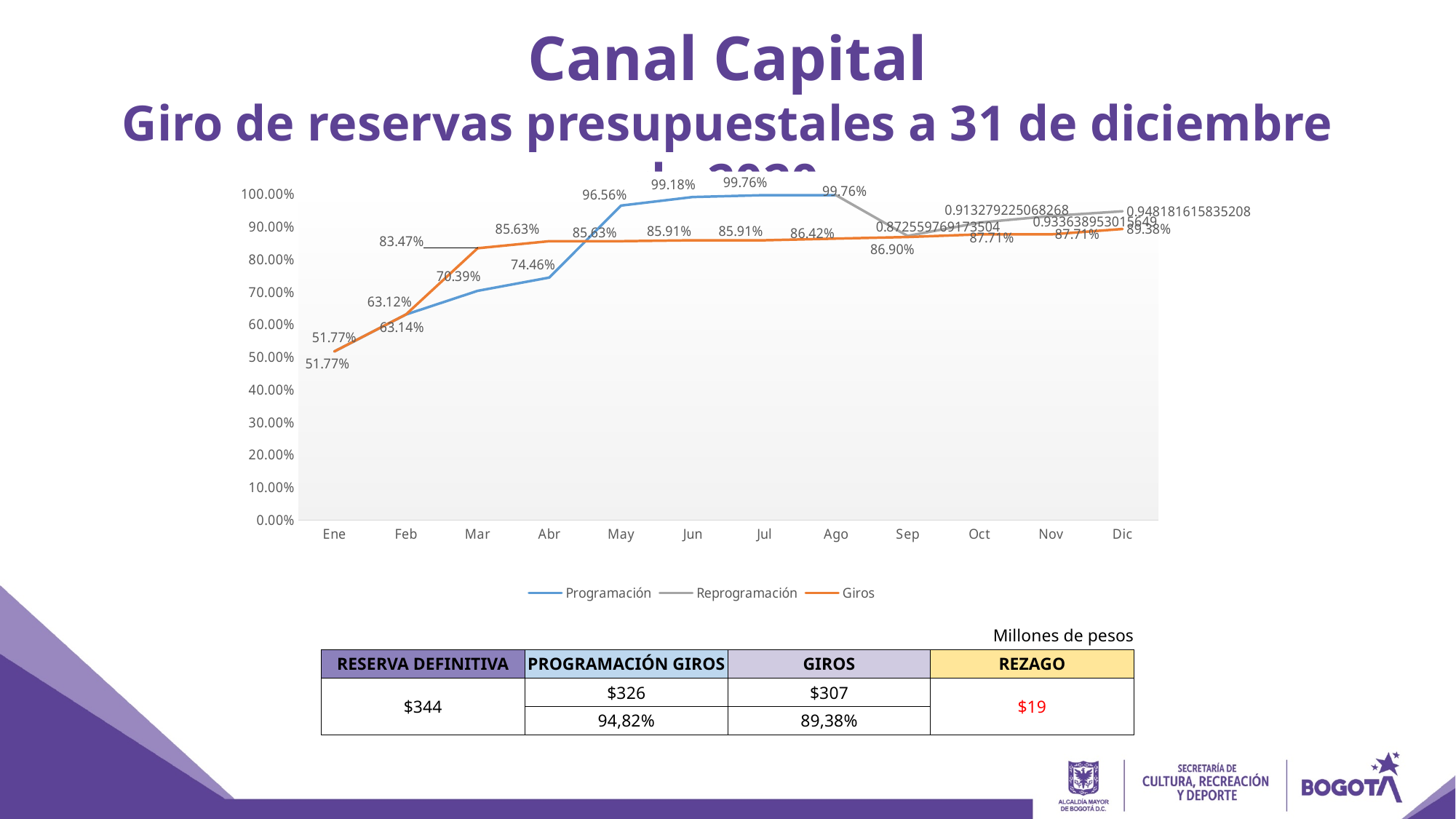
In May, which series has the larger value, Programación or Giros? Programación What is the Giros value for Dic? 89.38% What is the Programación value for Jun? 99.18% Is the Giros value for Jul greater or less than 90%? less What kind of chart is shown on the slide? line chart What is the difference between the Programación value and the Giros value in May? 10.93 percentage points What is the Programación value for Abr? 74.46% What is the Giros value for Mar? 83.47% Which series are listed in the chart legend? Programación, Reprogramación, Giros How many series does the chart legend list? 3 How many months are plotted along the x axis of the chart? 12 In which month does the Giros series reach its highest value? Dic